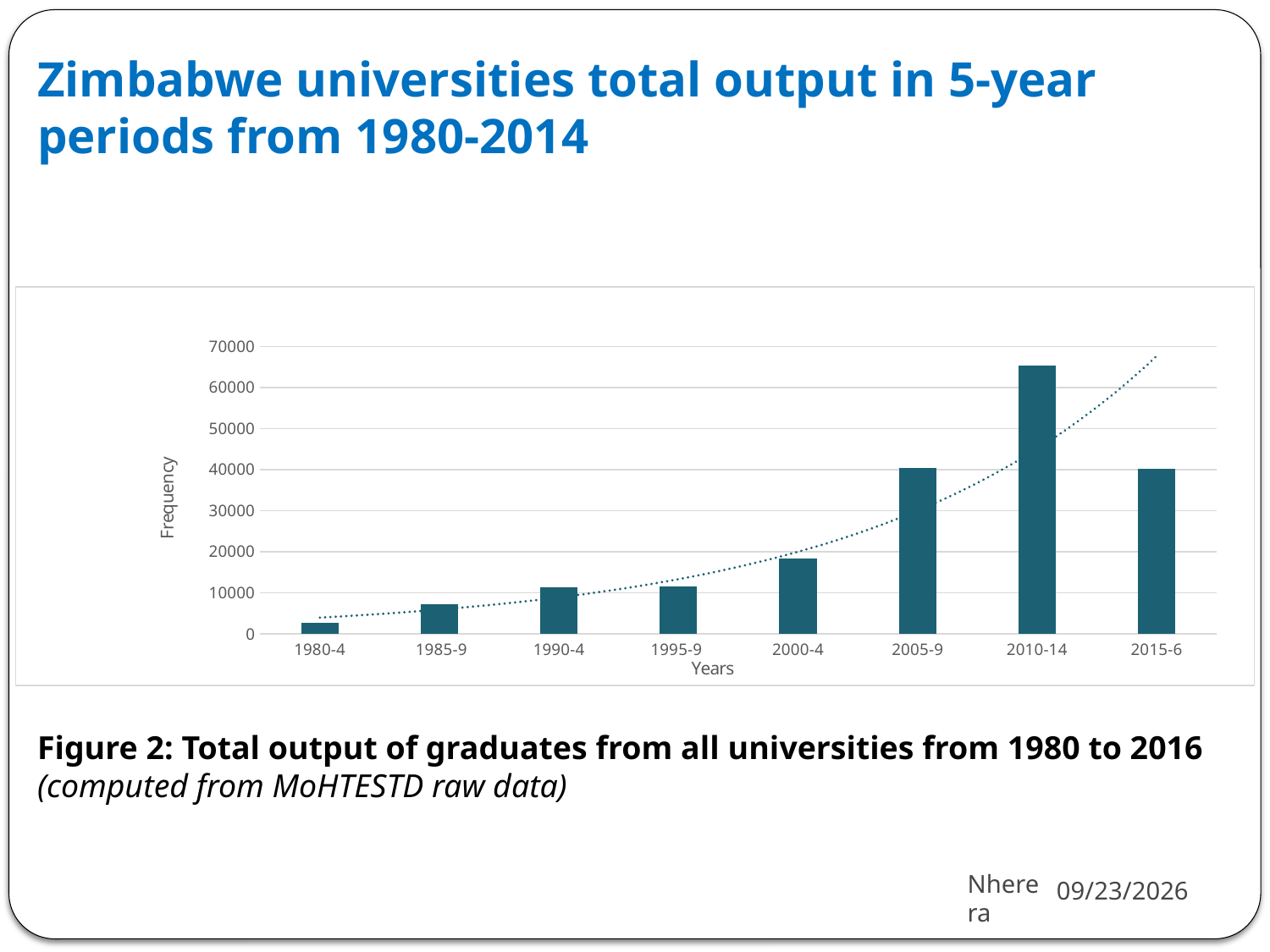
Which has a higher frequency, 1985-9 or 2000-4? 2000-4 Is the value for 2000-4 greater or less than 20000? less Is the value for 2005-9 greater or less than 30000? greater Is the value for 2010-14 greater or less than 60000? greater What kind of chart is shown on the slide? Bar chart How many year periods are shown on the x axis of the chart? 8 Which year period has the lowest frequency? 1980-4 Which year period has the highest frequency? 2010-14 What is the label on the vertical axis of the chart? Frequency Do the values generally rise or fall from 1980-4 to 2010-14? Rise Which has a higher frequency, 2005-9 or 2010-14? 2010-14